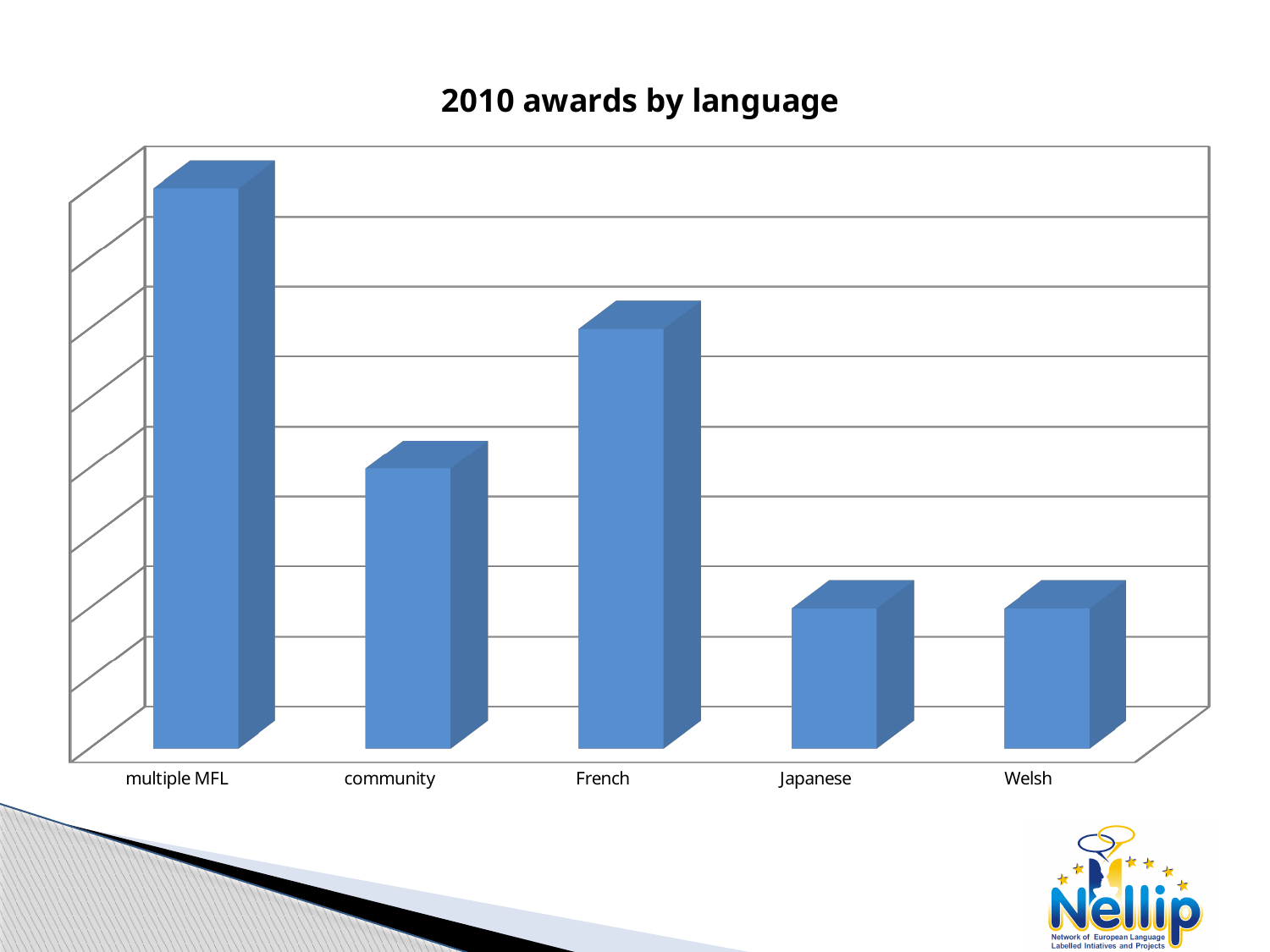
Which category has the highest value in the chart? multiple MFL What is the title of the chart? 2010 awards by language Which is larger, the value for French or the value for community? French Which is larger, the value for community or the value for Japanese? community How many categories are shown on the x axis of the chart? 5 Which category has the second-highest value in the chart? French What kind of chart is shown on the slide? bar chart Which is larger, the value for multiple MFL or the value for French? multiple MFL What colour are the bars in the chart? blue